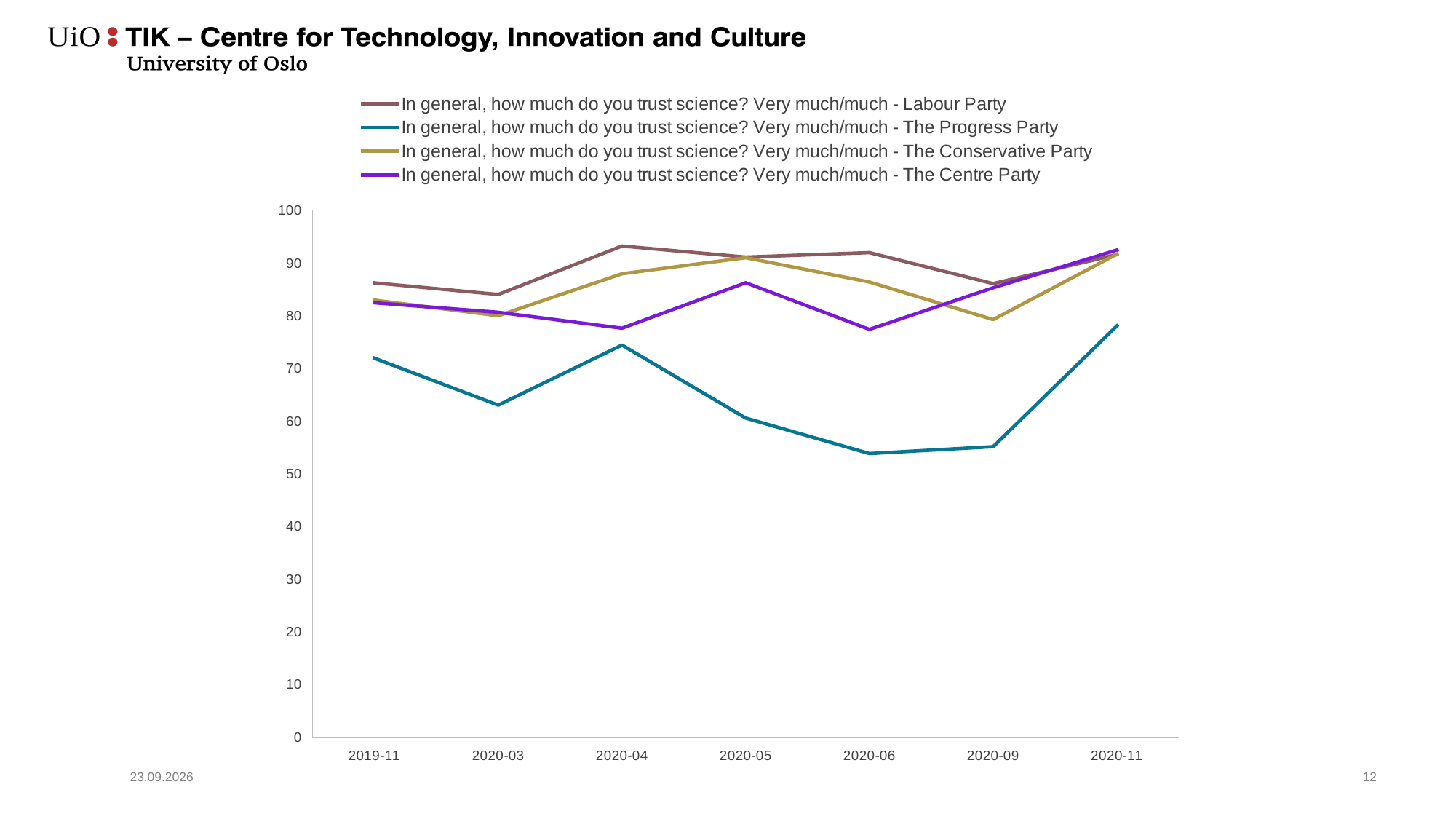
How many time points are shown on the x axis? 7 Is the value for The Centre Party at 2020-06 greater or less than 80? less Is the value for the Labour Party at 2020-09 greater or less than 80? greater Which party has the highest value at 2020-04? Labour Party Is the value for the Labour Party at 2020-04 greater or less than 90? greater What kind of chart is shown on the slide? line chart Does the value for The Progress Party rise or fall from 2020-09 to 2020-11? rise Which party has the lowest value at 2020-06? The Progress Party What colour is the line for The Centre Party? purple At 2020-03, which is larger: the value for the Labour Party or for The Progress Party? Labour Party How many series does the legend list? 4